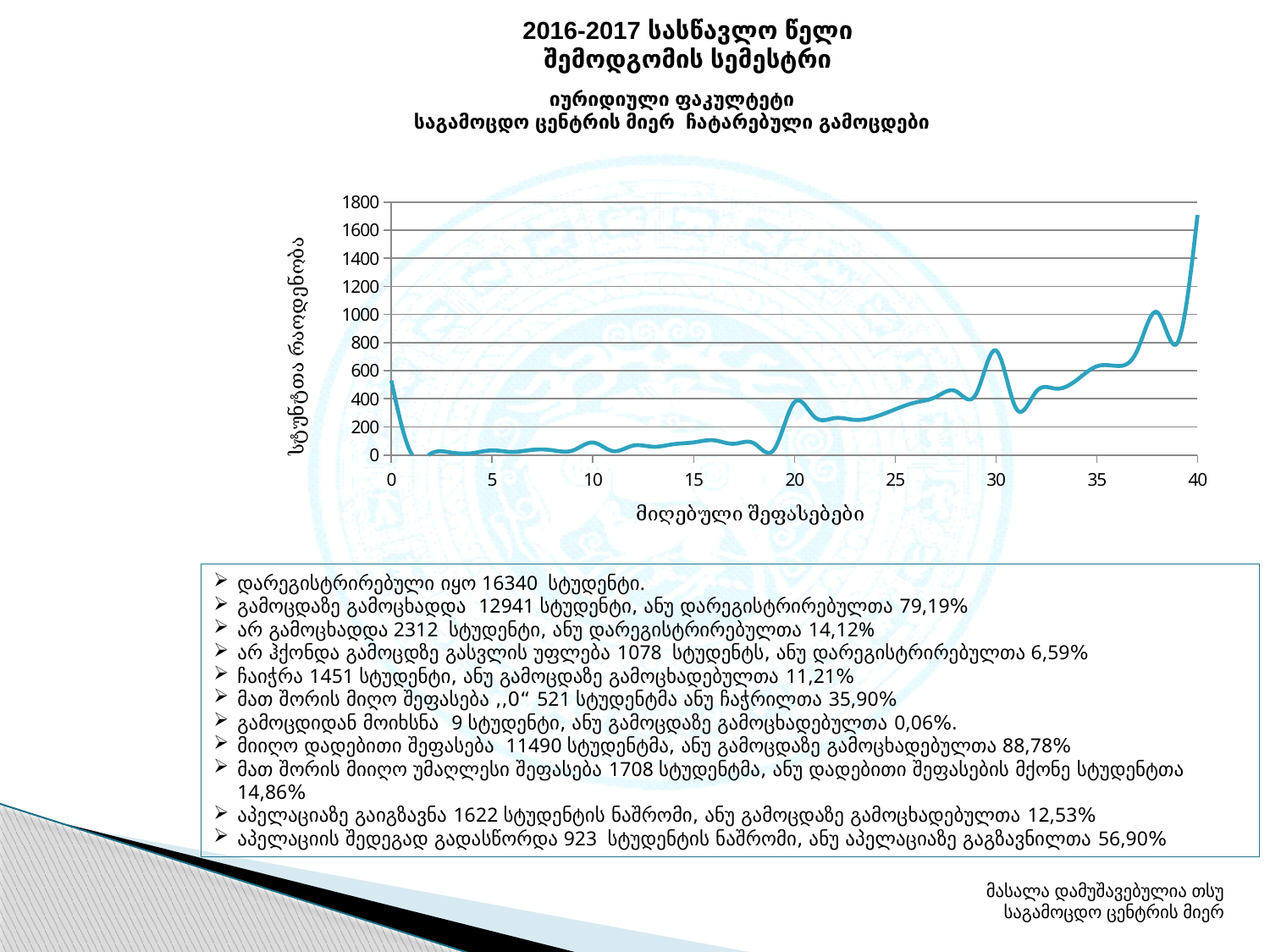
At which x-axis value does the line reach its highest point? 40 What kind of chart is shown on the slide? line chart Is the value of the line at x = 38 greater or less than 800? greater Is the value of the line at x = 0 greater or less than 400? greater Is the value of the line at x = 40 greater or less than 1400? greater What is the title of the x axis of the chart? მიღებული შეფასებები What is the title of the y axis of the chart? სტუდენტთა რაოდენობა Overall, does the line rise or fall as the x-axis value increases from 5 to 40? rise Which is larger, the value of the line at x = 30 or at x = 15? x = 30